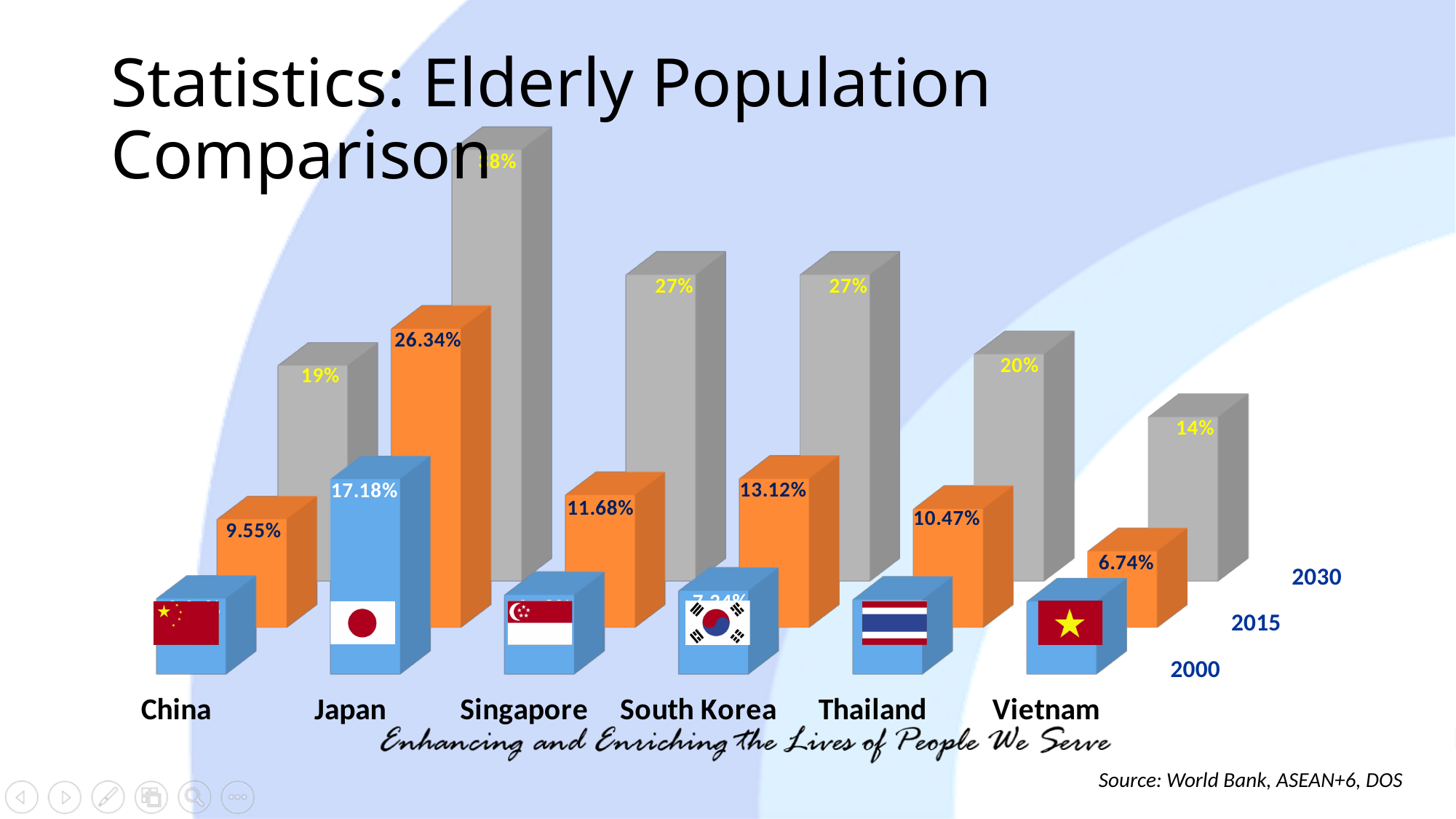
Which country has the lowest 2030 value? Vietnam Which country has the highest 2015 value? Japan How many countries are shown on the chart? 6 What is the difference between Japan's 2015 value and China's 2015 value? 16.79% What is the 2015 value for Vietnam? 6.74% Which is larger, the 2015 value for Singapore or the 2015 value for South Korea? South Korea What is the 2015 value for Japan? 26.34% What is the 2000 value for Japan? 17.18% What is the 2030 value for Singapore? 27% What is the difference between Thailand's 2030 value and Vietnam's 2030 value? 6% How many years (series) does the chart show? 3 What kind of chart is shown on the slide? Bar chart